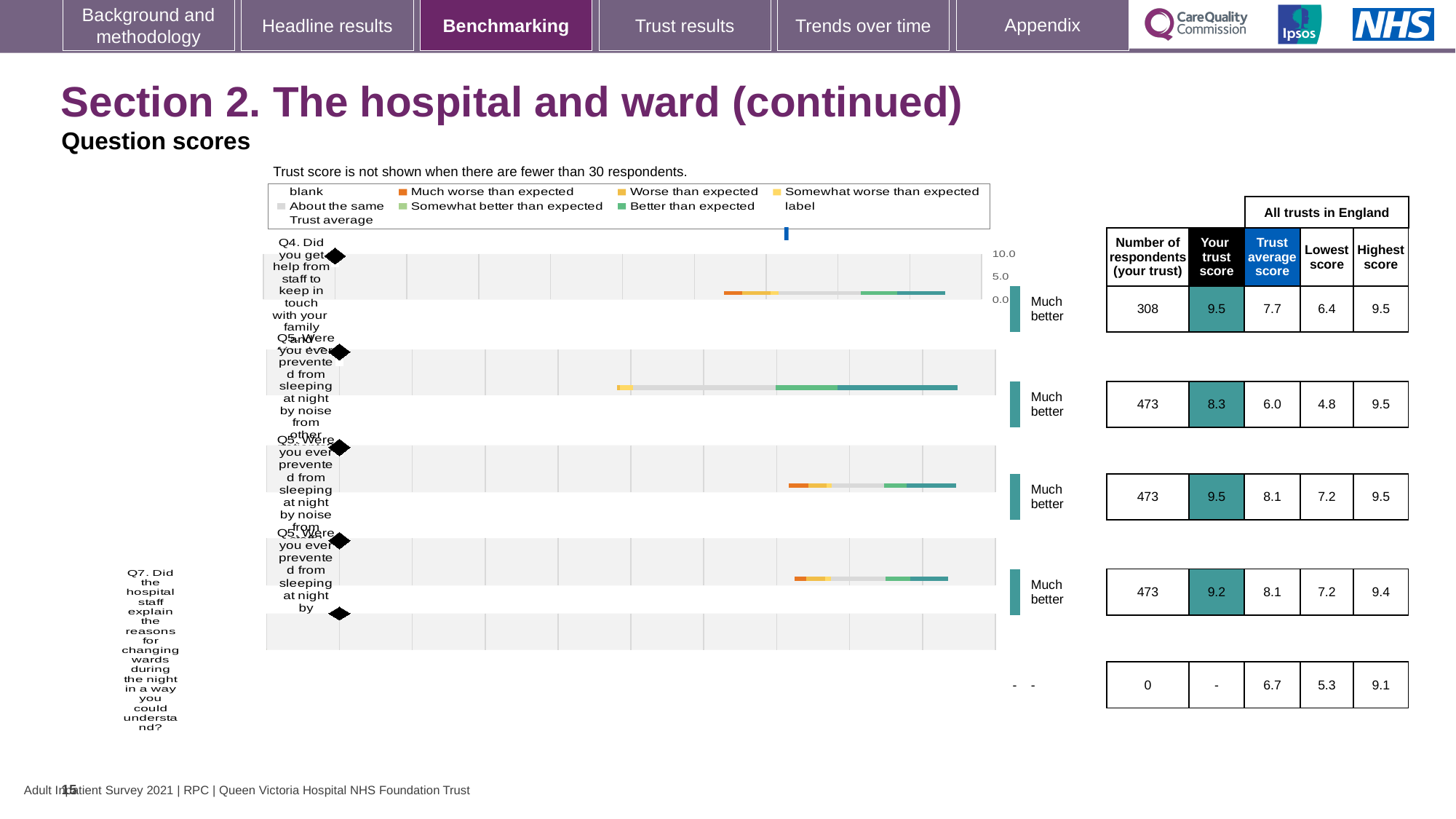
In the chart legend, which category is shown in dark orange? Much worse than expected In the table, what is the 'Your trust score' for Q4 (help from staff to keep in touch with family and friends)? 9.5 Which row of the table has the smallest 'Lowest score' value, and what is it? The second row, 4.8 In the table, what is the highest score for Q7 (explaining reasons for changing wards during the night)? 9.1 In the table, what is the trust average score for Q4? 7.7 In the table, how many respondents (your trust) are shown for Q4? 308 In the table, how many respondents are shown for Q7 (explaining reasons for changing wards during the night)? 0 How many question rows are shown in the table on the right? 5 In the second row of the table, which is larger: the 'Your trust score' (8.3) or the trust average score (6.0)? Your trust score By how much does the 'Your trust score' for Q4 exceed the trust average score for Q4? 1.8 In the table, what is the 'Your trust score' in the fourth row (473 respondents, highest score 9.4)? 9.2 What kind of chart is used to show the question scores on this slide? bar chart